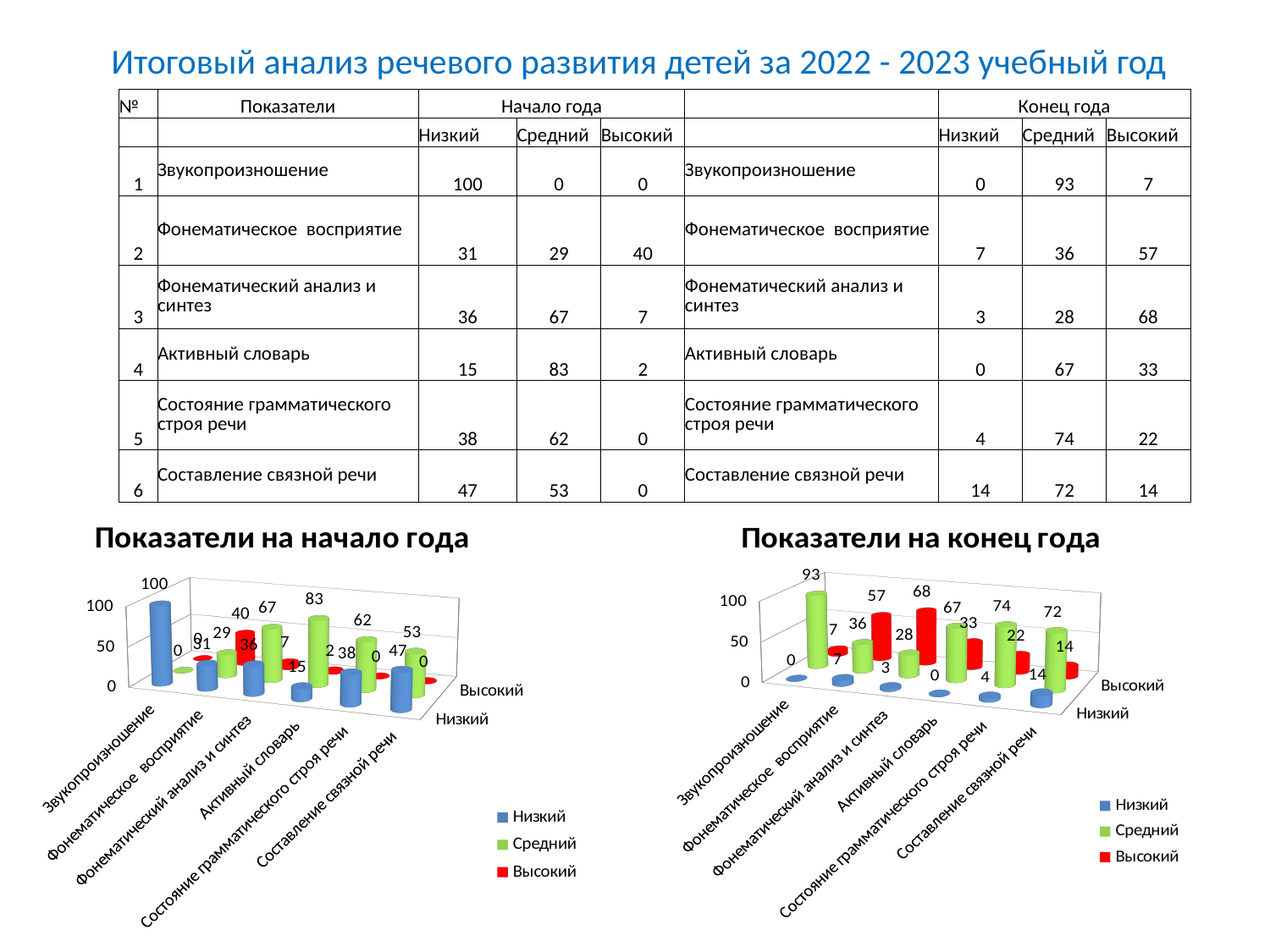
In "Показатели на конец года", which has the larger Высокий value: Фонематическое восприятие or Активный словарь? Фонематическое восприятие In "Показатели на конец года", which category has the lowest Средний value? Фонематический анализ и синтез In "Показатели на конец года", which category has the highest Высокий value? Фонематический анализ и синтез What kind of chart is "Показатели на начало года"? bar chart In "Показатели на начало года", which category has the highest Средний value? Активный словарь In "Показатели на начало года", what is the Низкий value for Звукопроизношение? 100 In "Показатели на конец года", what is the Средний value for Звукопроизношение? 93 In "Показатели на начало года", what is the Средний value for Составление связной речи? 53 In "Показатели на конец года", what is the difference between the Средний values for Состояние грамматического строя речи and Составление связной речи? 2 How many categories are shown on the x axis of "Показатели на начало года"? 6 What is the title of the chart on the right side of the slide? Показатели на конец года How many series does the legend of "Показатели на конец года" list? 3